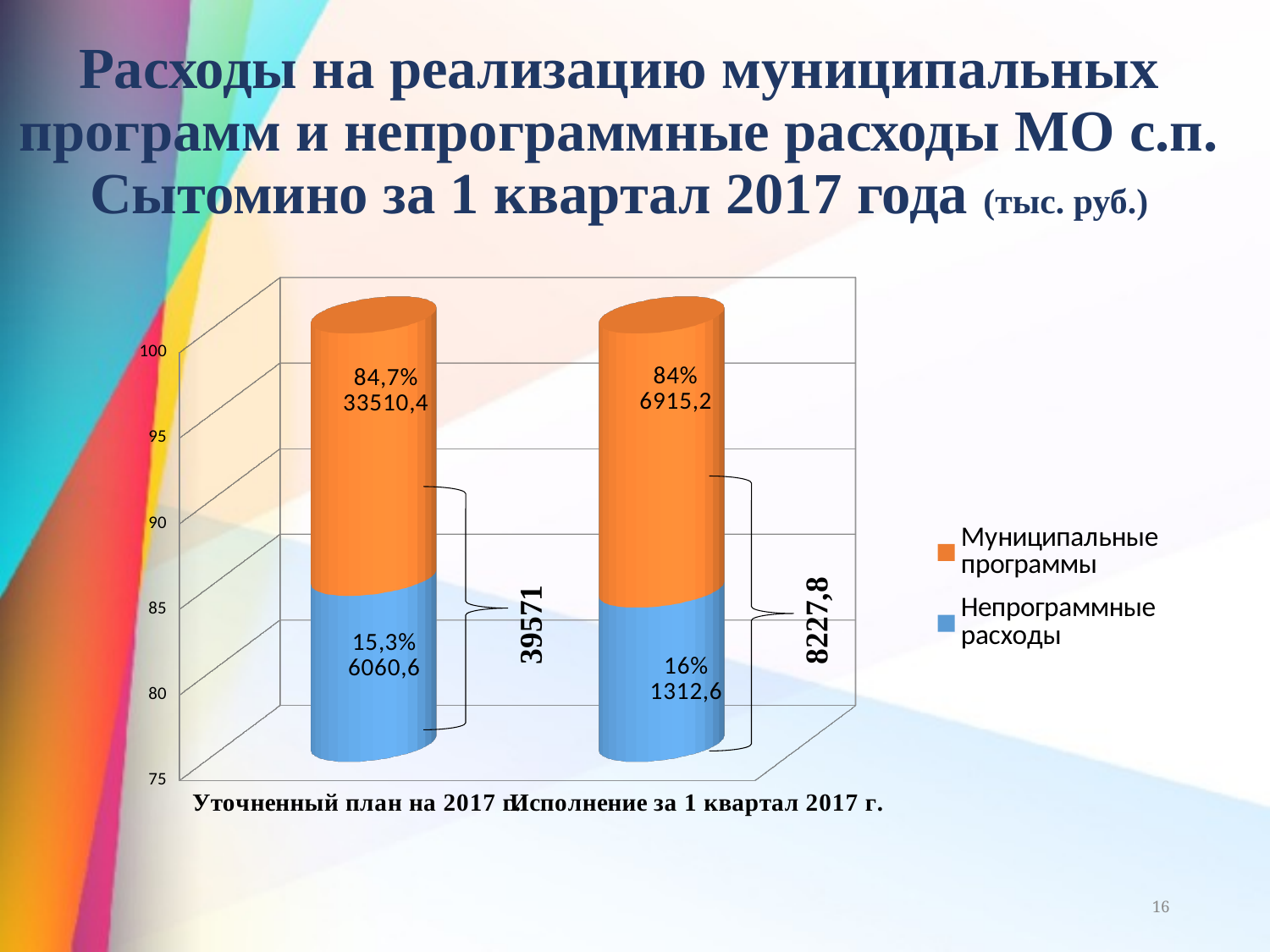
What percentage share is shown for Непрограммные расходы in Исполнение за 1 квартал 2017 г.? 16% Which series is shown in orange in the legend? Муниципальные программы What is the value of Муниципальные программы for Уточненный план на 2017 г.? 33510,4 How many series does the legend list? 2 What kind of chart is shown on the slide? bar chart How many categories are shown on the x axis? 2 What is the value of Непрограммные расходы for Уточненный план на 2017 г.? 6060,6 What percentage share is shown for Муниципальные программы in Уточненный план на 2017 г.? 84,7% What is the total shown for the Исполнение за 1 квартал 2017 г. bar? 8227,8 What is the value of Муниципальные программы for Исполнение за 1 квартал 2017 г.? 6915,2 What is the value of Непрограммные расходы for Исполнение за 1 квартал 2017 г.? 1312,6 What is the total shown for the Уточненный план на 2017 г. bar? 39571